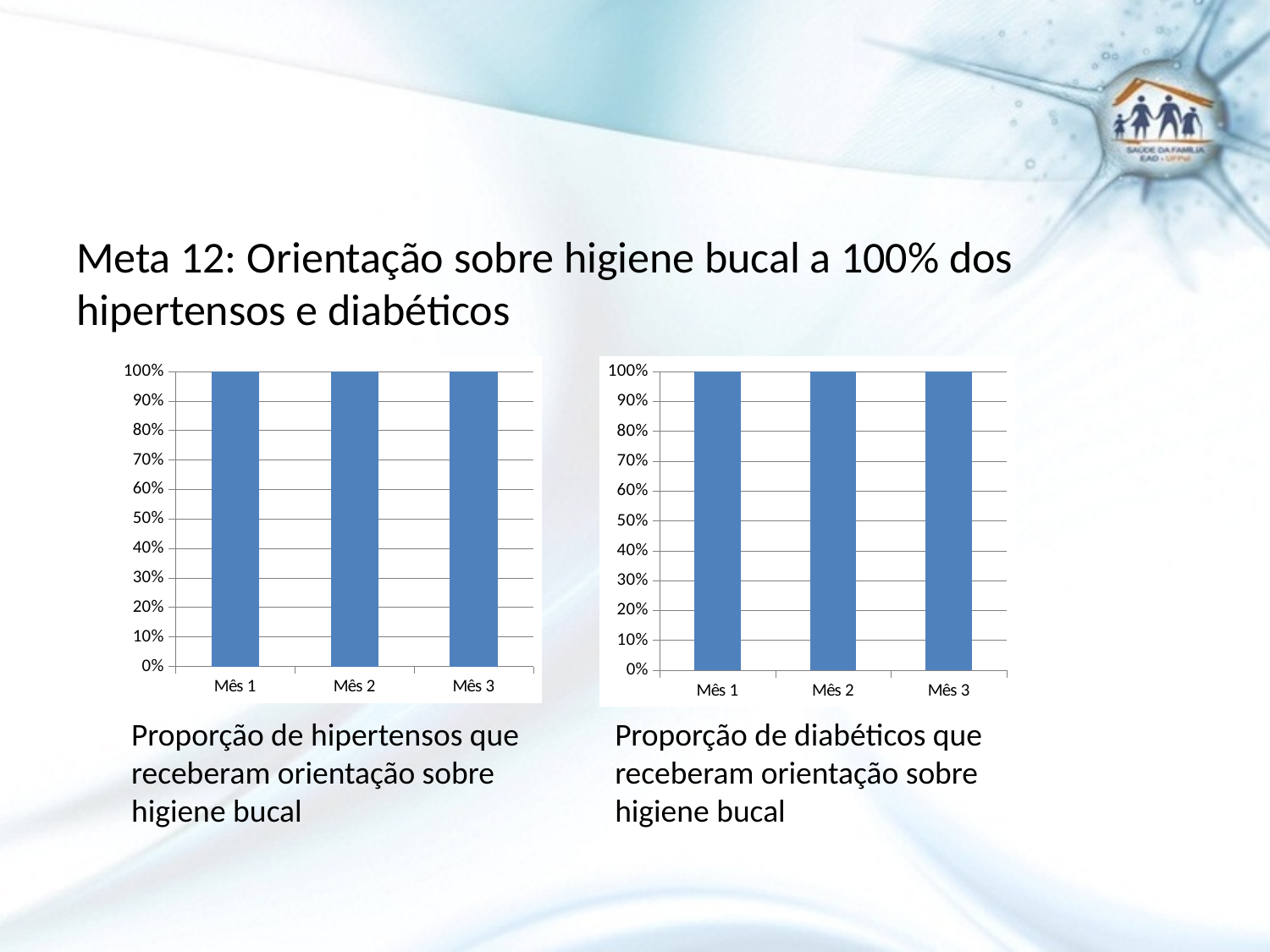
In the right chart (Proporção de diabéticos), what is the value for Mês 1? 100% How many bars are plotted in the right chart (Proporção de diabéticos)? 3 In the left chart (Proporção de hipertensos que receberam orientação sobre higiene bucal), what is the value for Mês 1? 100% How many categories are shown on the x axis of the left chart (Proporção de hipertensos)? 3 What is the caption below the left chart? Proporção de hipertensos que receberam orientação sobre higiene bucal In the left chart (Proporção de hipertensos), do the values rise, fall or stay the same from Mês 1 to Mês 3? Stay the same In the right chart (Proporção de diabéticos), what is the difference between the values for Mês 2 and Mês 3? 0% In the right chart (Proporção de diabéticos que receberam orientação sobre higiene bucal), what is the value for Mês 3? 100% What kind of chart is the left chart (Proporção de hipertensos)? Bar chart What kind of chart is the right chart (Proporção de diabéticos)? Bar chart In the left chart (Proporção de hipertensos), what is the value for Mês 2? 100% In the right chart (Proporção de diabéticos), do the values rise, fall or stay the same from Mês 1 to Mês 3? Stay the same